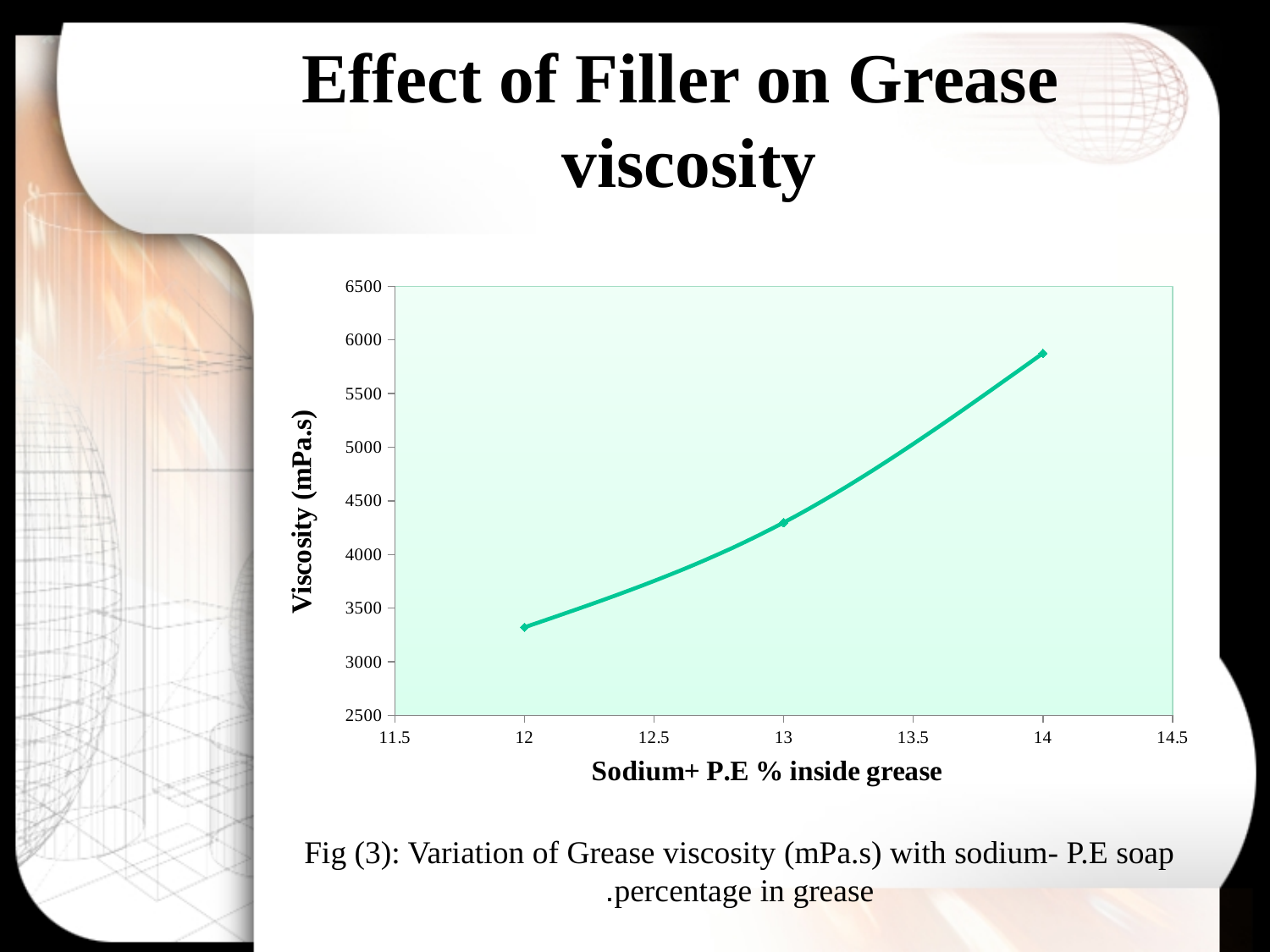
Is the viscosity at Sodium+ P.E % of 14 greater or less than 5500? greater What is the label of the x axis of the chart? Sodium+ P.E % inside grease At which Sodium+ P.E % value is the viscosity lowest? 12 Is the viscosity at Sodium+ P.E % of 13 greater or less than 4000? greater Does the viscosity rise or fall as the Sodium+ P.E % inside grease increases? rise What kind of chart is shown on the slide? line chart At which Sodium+ P.E % value is the viscosity highest? 14 Is the viscosity at Sodium+ P.E % of 12 greater or less than 3500? less Which has the larger viscosity: Sodium+ P.E % of 13 or 12? 13 How many data points are plotted on the chart? 3 What is the label of the y axis of the chart? Viscosity (mPa.s)